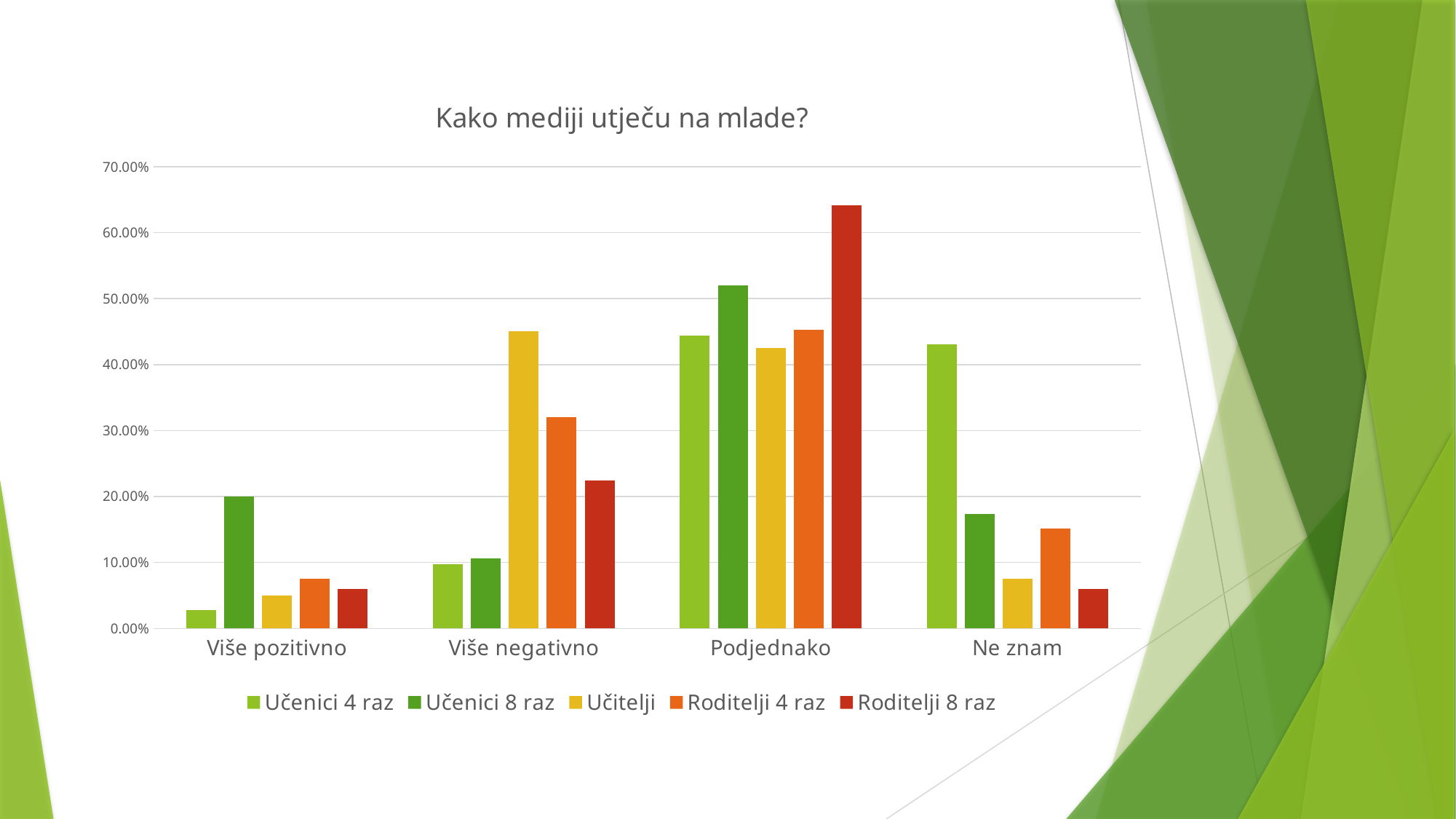
In the Više negativno category, which is larger: Učitelji or Roditelji 4 raz? Učitelji How many series does the legend list? 5 What is the title of the chart? Kako mediji utječu na mlade? Which series has the lowest value in the Više pozitivno category? Učenici 4 raz Which series has the highest value in the Ne znam category? Učenici 4 raz In the Ne znam category, which is larger: Učenici 4 raz or Učenici 8 raz? Učenici 4 raz How many categories are shown on the x axis? 4 Is the value for Roditelji 8 raz in the Podjednako category greater or less than 60.00%? greater Which series has the highest value in the Podjednako category? Roditelji 8 raz Is the value for Učenici 8 raz in the Više pozitivno category greater or less than 10.00%? greater What kind of chart is shown on the slide? bar chart Is the value for Učitelji in the Više negativno category greater or less than 40.00%? greater